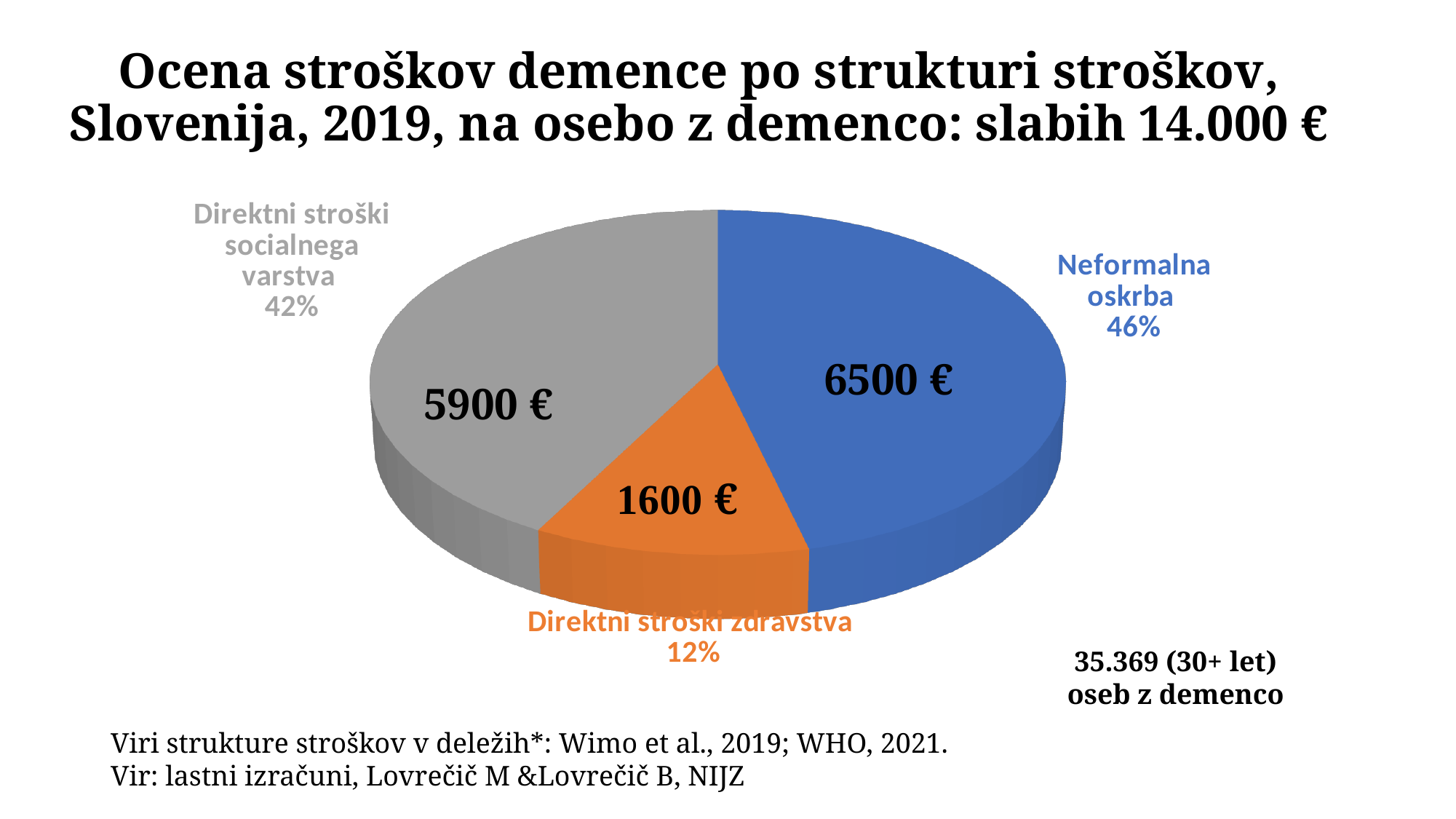
What kind of chart is shown on the slide? pie chart Which is larger, Direktni stroški socialnega varstva or Direktni stroški zdravstva? Direktni stroški socialnega varstva What share of the pie does Direktni stroški zdravstva represent? 12% Which category has the largest slice of the pie? Neformalna oskrba What share of the pie does Neformalna oskrba represent? 46% What is the value shown for Direktni stroški zdravstva? 1600 € What is the value shown for Neformalna oskrba? 6500 € How many slices does the pie chart have? 3 What is the difference in euros between Neformalna oskrba and Direktni stroški socialnega varstva? 600 € Which category has the smallest slice of the pie? Direktni stroški zdravstva What colour is the slice for Direktni stroški zdravstva? orange What is the value shown for Direktni stroški socialnega varstva? 5900 €